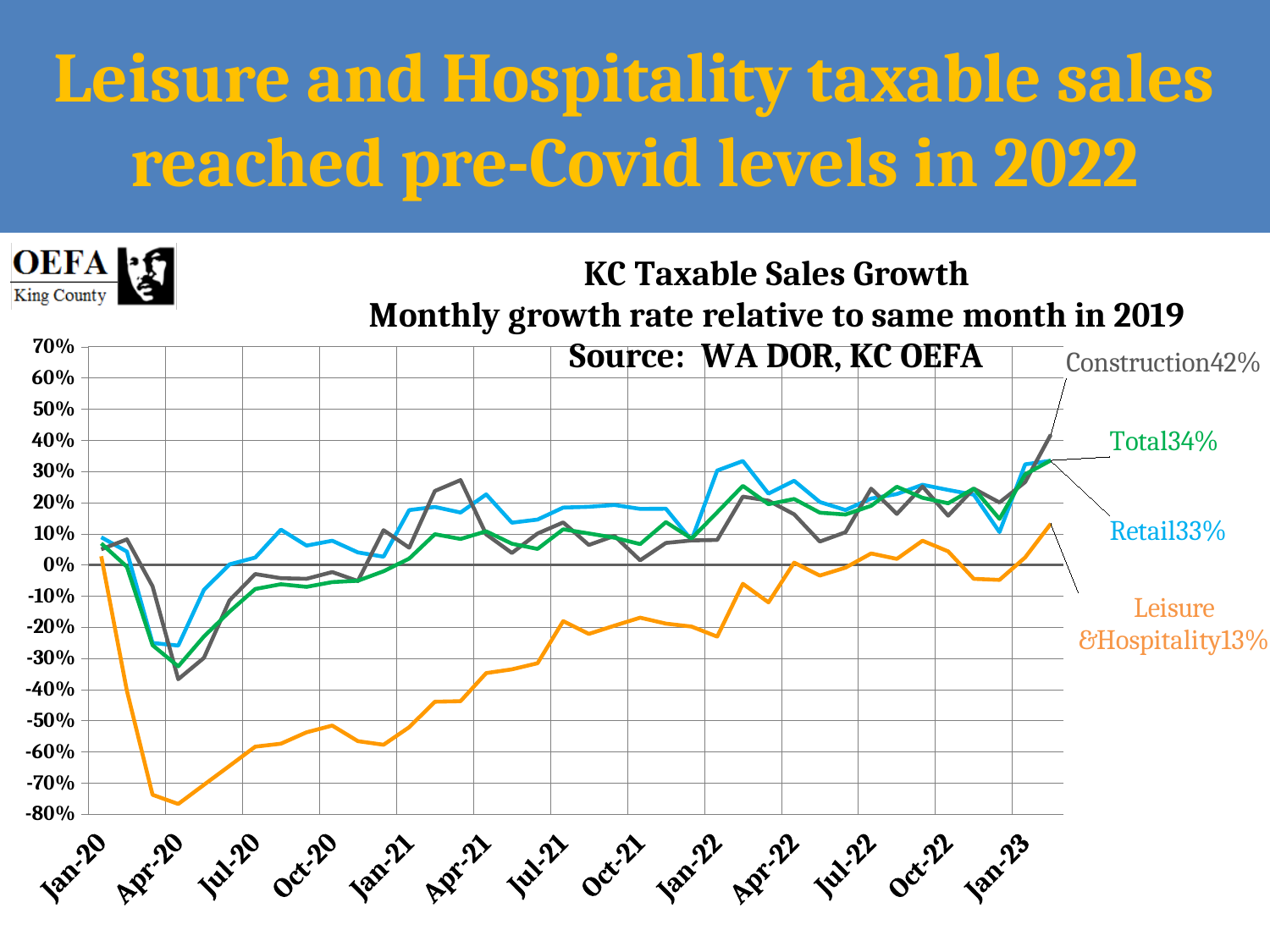
What is the title of the chart? KC Taxable Sales Growth What kind of chart is shown on the slide? Line chart Which has the larger final labelled value, Construction or Retail? Construction Is the value for Leisure & Hospitality around Apr-20 greater or less than -70%? less Which series has the lowest labelled value at the end of the chart? Leisure & Hospitality What is the difference between the final labelled values for Construction (42%) and Leisure & Hospitality (13%)? 29 percentage points Which series has the highest labelled value at the end of the chart? Construction What is the final labelled value for the Construction series? 42% Is the value for Leisure & Hospitality around Jan-21 greater or less than -50%? less What is the final labelled value for the Total series? 34% What is the final labelled value for the Leisure & Hospitality series? 13% How many series are plotted on the chart? 4